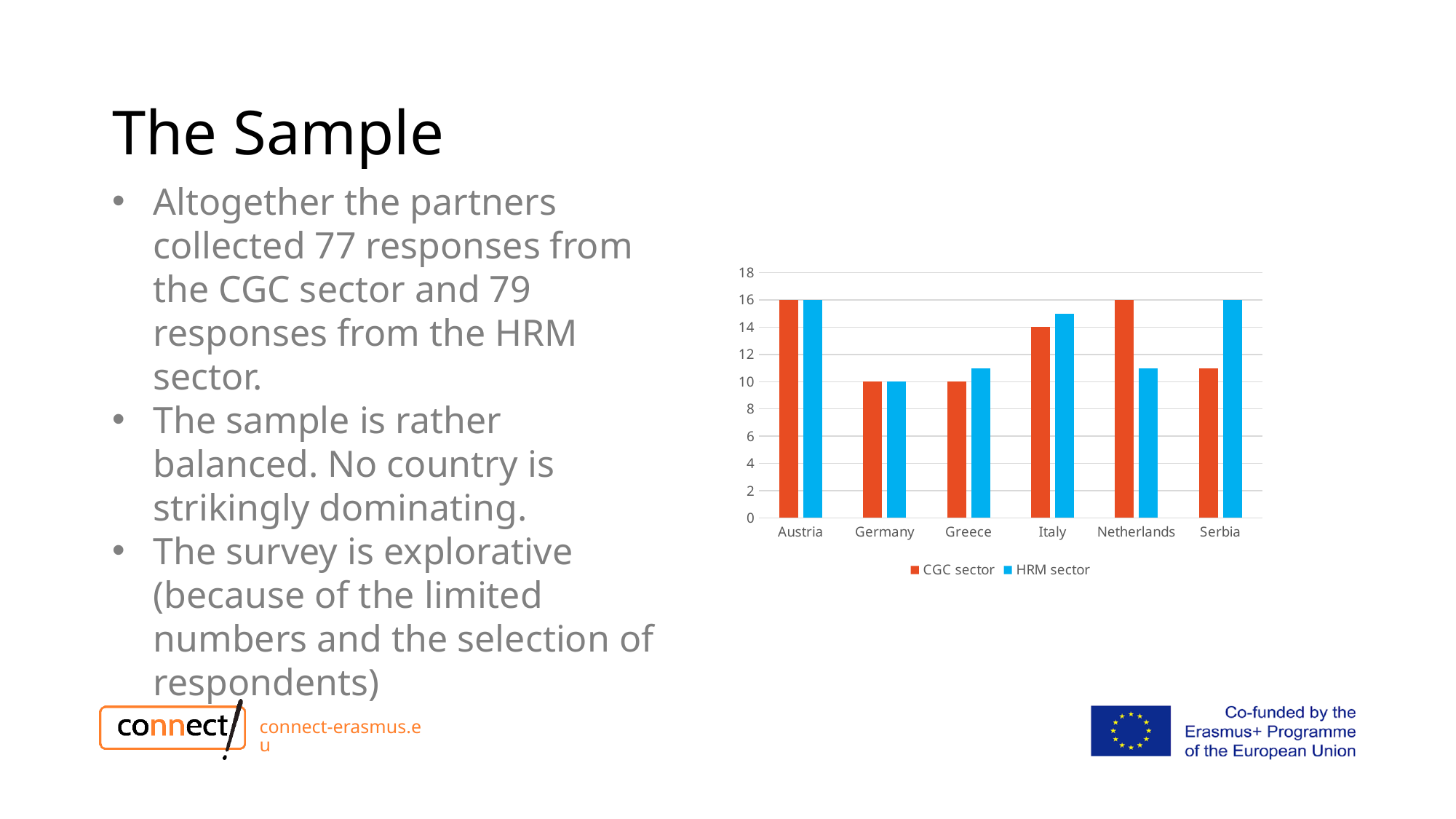
How many countries are shown on the x axis of the chart? 6 How many series does the chart legend list? 2 What is the value for the HRM sector in Serbia? 16 Which is larger in Serbia, the CGC sector or the HRM sector? HRM sector What is the value for the CGC sector in Austria? 16 What is the difference between the CGC sector values for Netherlands and Germany? 6 What type of chart is shown on the slide? bar chart Is the value for the HRM sector in Netherlands greater or less than 12? less Is the value for the HRM sector in Italy greater or less than 12? greater What is the value for the HRM sector in Germany? 10 What is the value for the CGC sector in Netherlands? 16 Which is larger in Netherlands, the CGC sector or the HRM sector? CGC sector